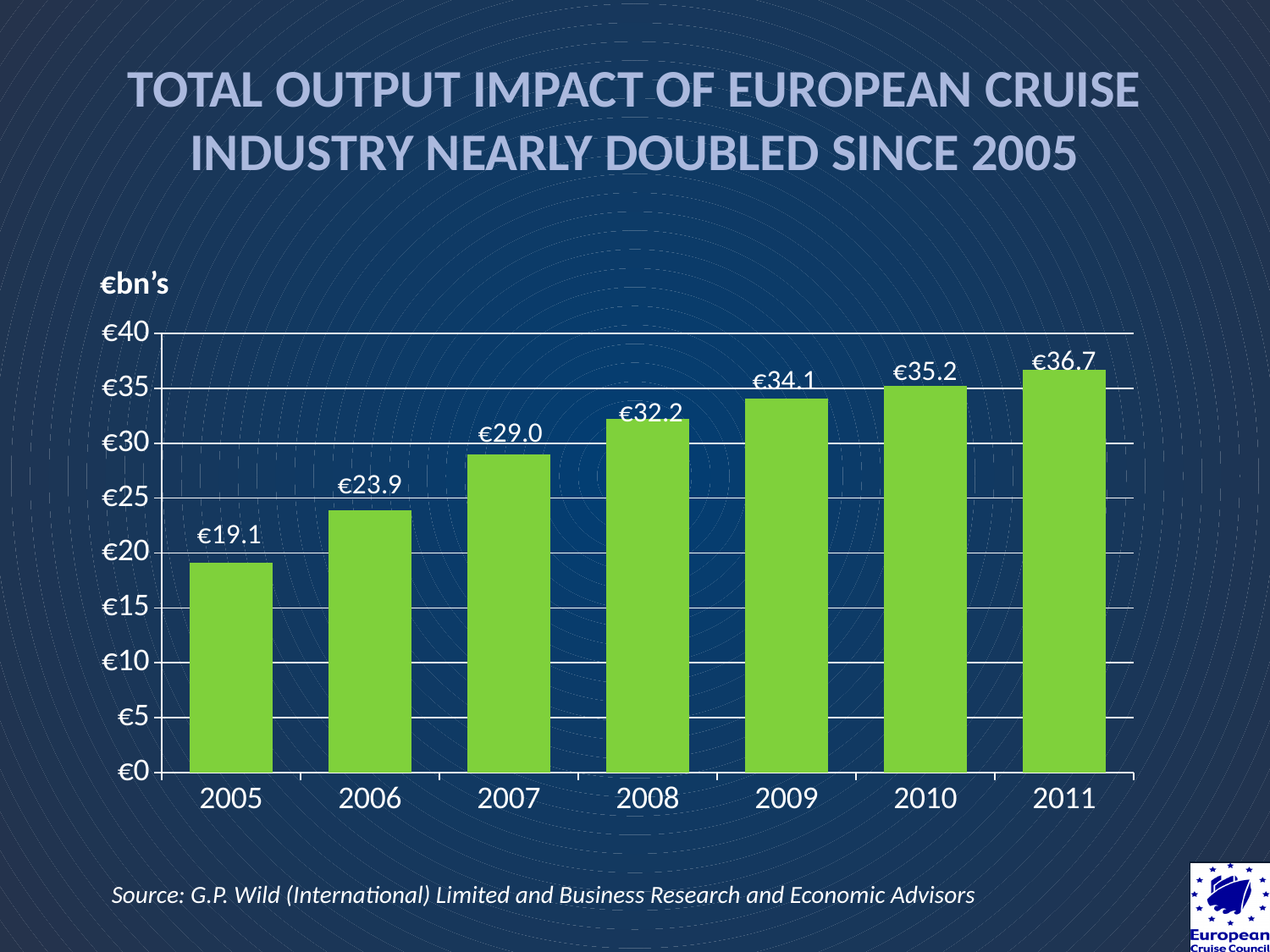
What is the value for 2008? €32.2 Which year has the lowest value? 2005 What is the difference between the values for 2007 and 2006? €5.1 What is the value for 2011? €36.7 Is the value for 2006 greater or less than €25? less Which year has the highest value? 2011 Do the values rise or fall from 2005 to 2011? rise Which is larger, the value for 2009 or the value for 2007? 2009 What is the value for 2005? €19.1 How many years are shown on the x axis? 7 What kind of chart is this? bar chart What is the difference between the values for 2011 and 2005? €17.6